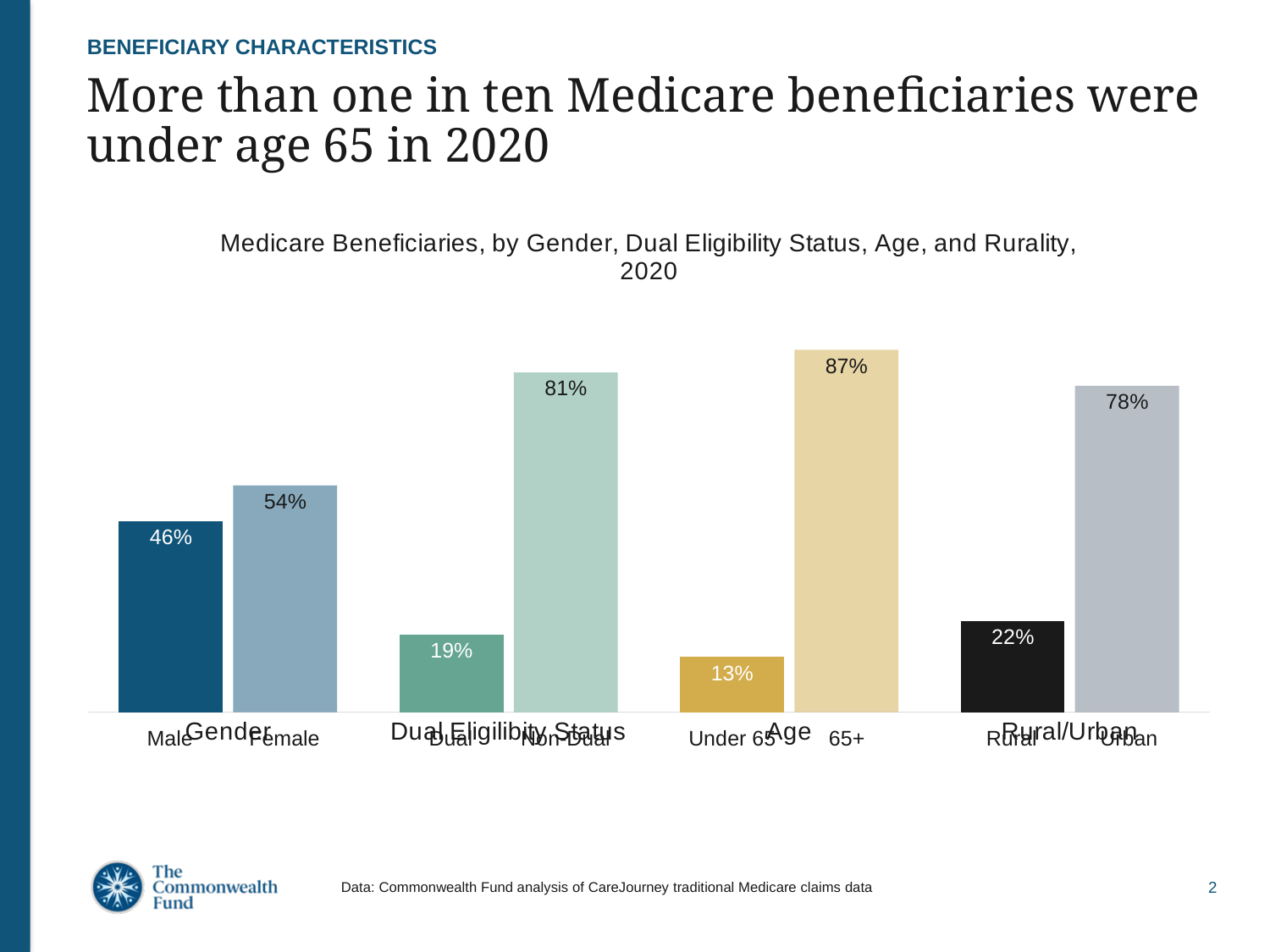
What is the title of the chart? Medicare Beneficiaries, by Gender, Dual Eligibility Status, Age, and Rurality, 2020 How many bars are plotted in the chart? 8 Which category has the highest value in the chart? 65+ What is the difference between the Female and Male percentages? 8 percentage points What percentage of Medicare beneficiaries were dual eligible? 19% Which is larger, the Urban share or the Non-Dual share? Non-Dual Which category has the lowest value in the chart? Under 65 What percentage of Medicare beneficiaries lived in rural areas? 22% What is the difference between the Non-Dual and Dual percentages? 62 percentage points What percentage of Medicare beneficiaries were female? 54% What percentage of Medicare beneficiaries were under age 65 in 2020? 13% What type of chart is shown on the slide? Bar chart